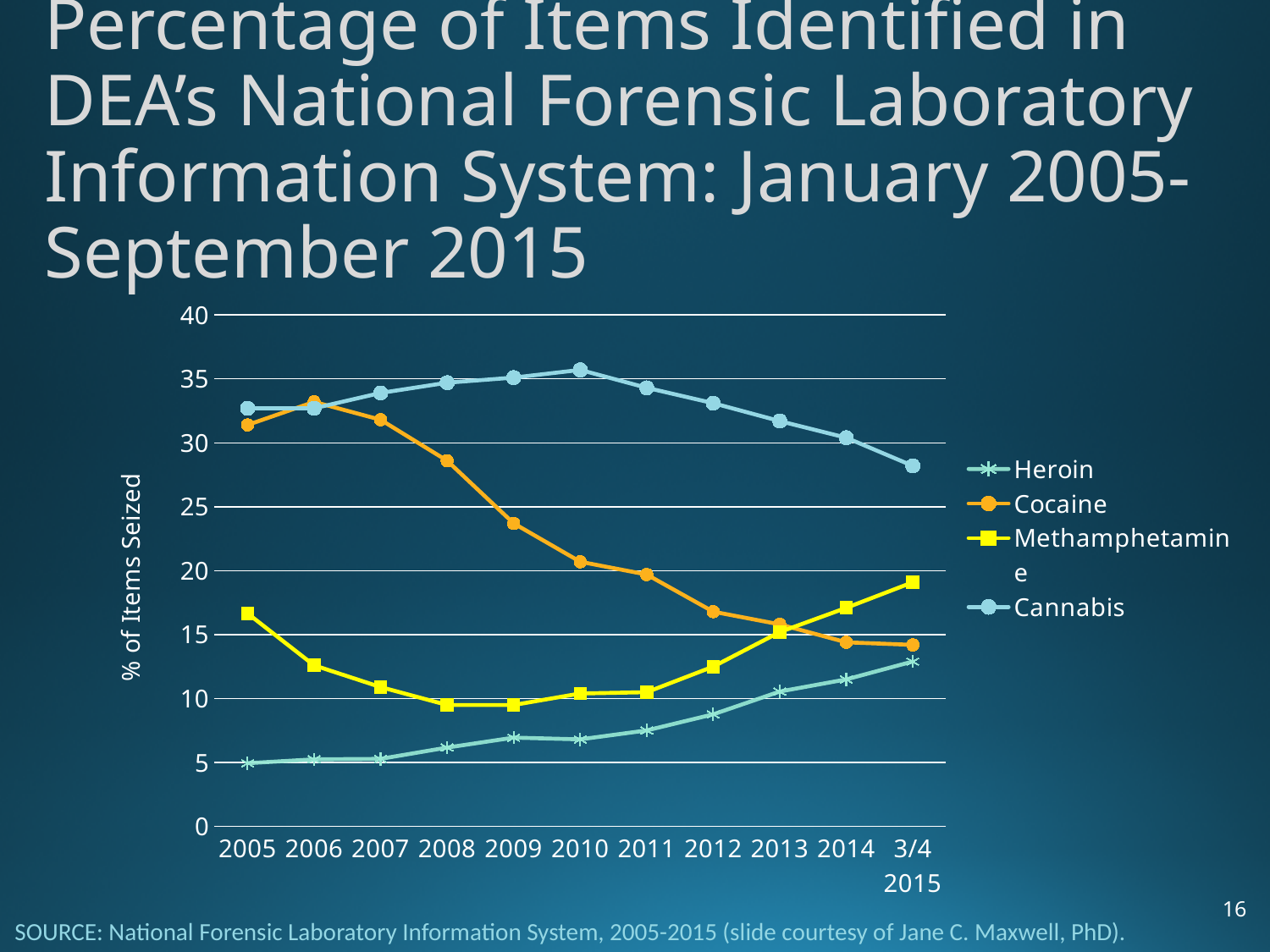
How many time points are plotted along the x axis? 11 What is the label on the y axis? % of Items Seized How many series does the legend list? 4 Does the Cocaine line rise or fall from 2006 to 3/4 2015? fall Is the value for Cannabis in 2005 greater or less than 30? greater Is the value for Cocaine in 2009 greater or less than 20? greater In 2014, which is larger: the value for Methamphetamine or the value for Cocaine? Methamphetamine What kind of chart is shown on the slide? line chart Does the Heroin line rise or fall from 2005 to 3/4 2015? rise Which series has the highest value in 2010? Cannabis Which series has the lowest value in 2005? Heroin Is the value for Heroin in 2005 greater or less than 10? less